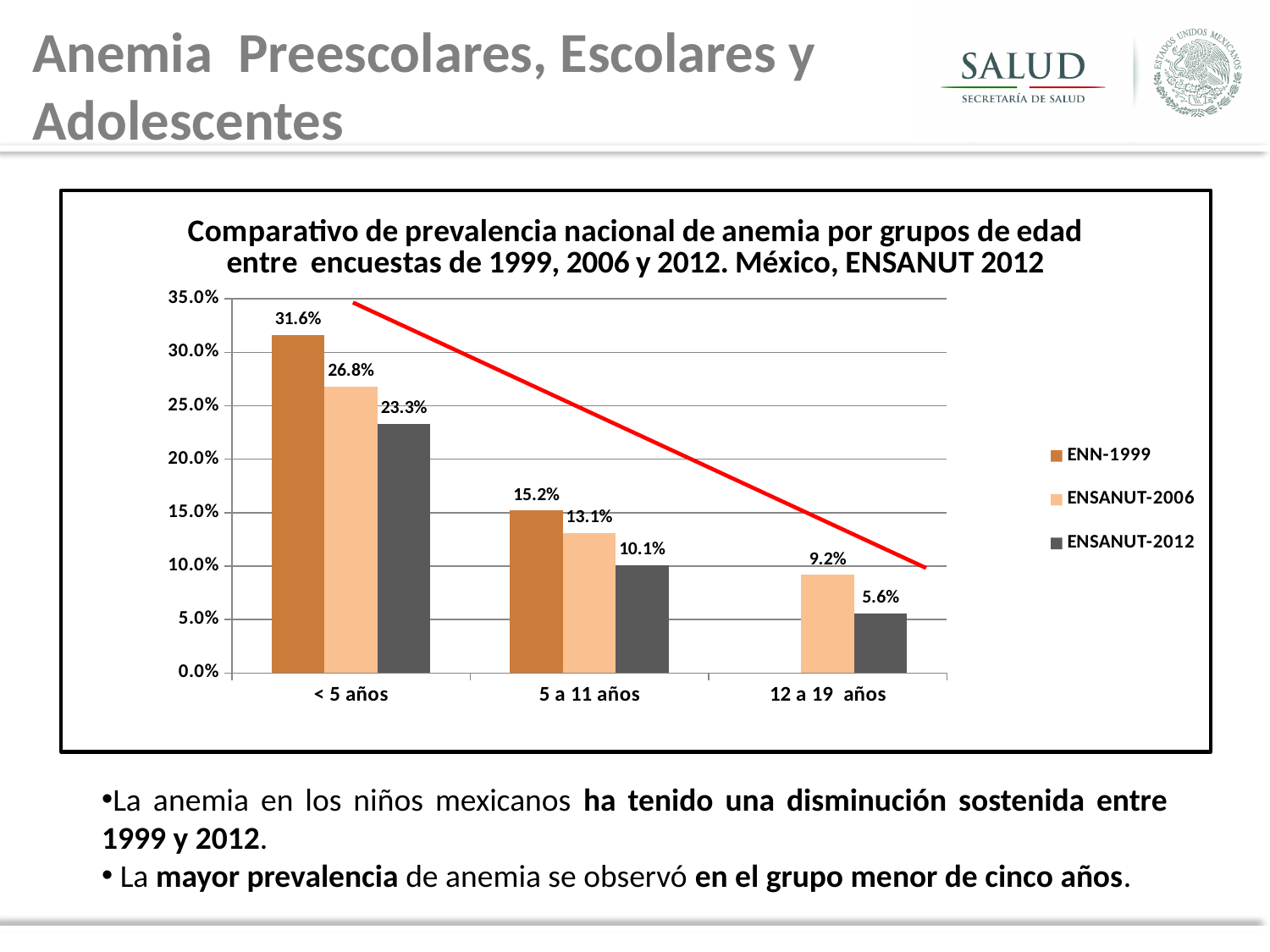
How many series does the legend list? 3 What kind of chart is shown? bar chart How many age groups are shown on the x axis? 3 What is the ENSANUT-2012 value for the 5 a 11 años group? 10.1% Which is larger for the 5 a 11 años group: the ENN-1999 value or the ENSANUT-2006 value? ENN-1999 Which age group has the lowest ENSANUT-2006 value? 12 a 19 años What is the ENSANUT-2006 value for the 12 a 19 años group? 9.2% Is the ENSANUT-2012 value for the 12 a 19 años group greater or less than 10.0%? less Do the ENSANUT-2012 values rise or fall as age group increases along the x axis? fall What is the difference between the ENN-1999 and ENSANUT-2012 values for the < 5 años group? 8.3% Which age group has the highest ENSANUT-2012 value? < 5 años What is the ENN-1999 value for the < 5 años group? 31.6%